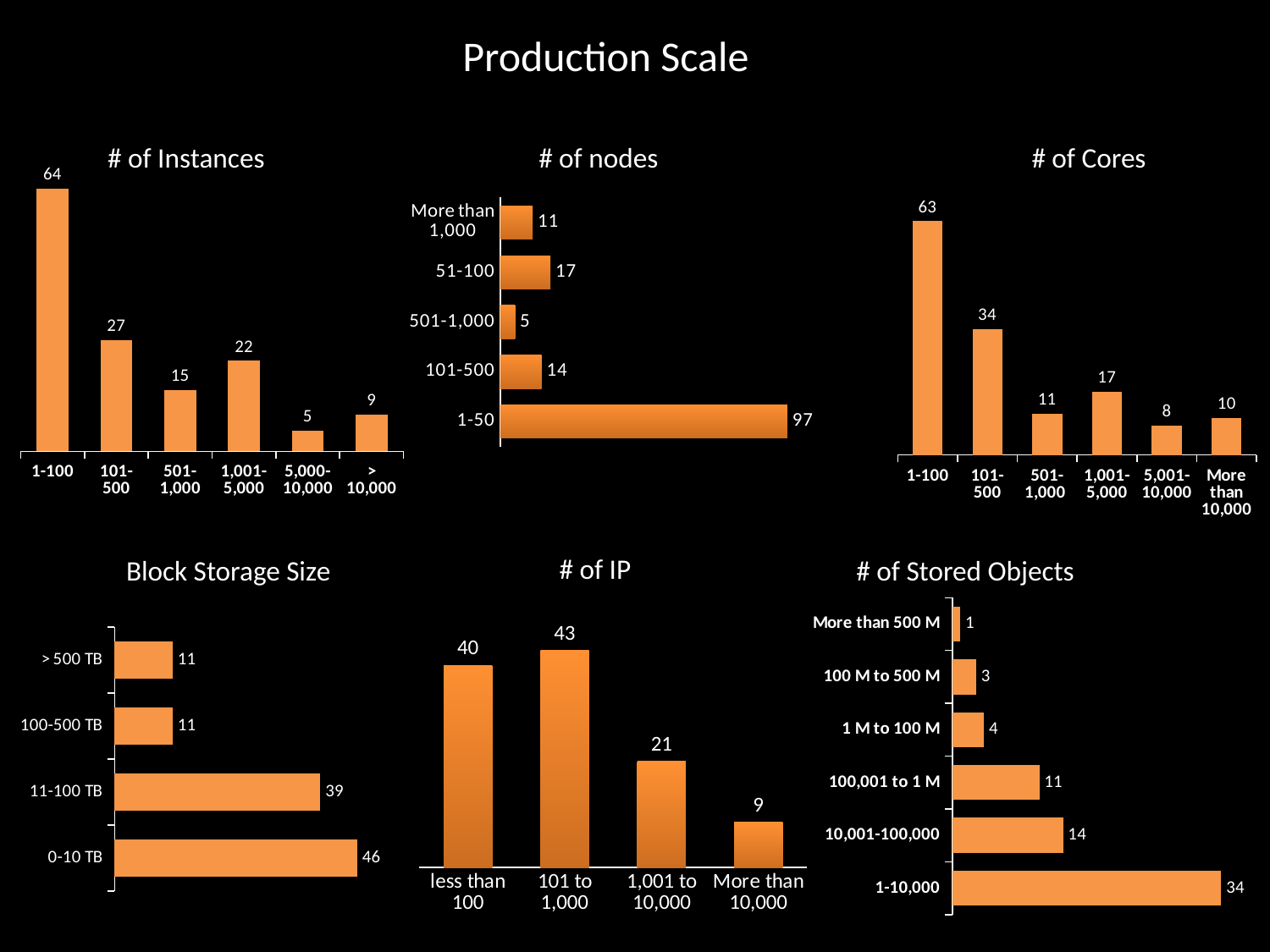
In the "Block Storage Size" chart, what is the value for 11-100 TB? 39 In the "# of nodes" chart, what is the value for 501-1,000? 5 In the "# of IP" chart, which is larger: the value for less than 100 or the value for 101 to 1,000? 101 to 1,000 In the "# of Cores" chart, which category has the lowest value? 5,001-10,000 In the "# of nodes" chart, which category has the highest value? 1-50 In the "# of Stored Objects" chart, how many categories are shown? 6 What kind of chart is the "# of Instances" chart? Bar chart In the "Block Storage Size" chart, how many categories are shown? 4 In the "# of IP" chart, what is the value for More than 10,000? 9 In the "# of Cores" chart, what is the difference between the 1-100 value and the 101-500 value? 29 In the "# of Stored Objects" chart, what is the value for 10,001-100,000? 14 In the "# of Instances" chart, what is the value for the 1-100 category? 64